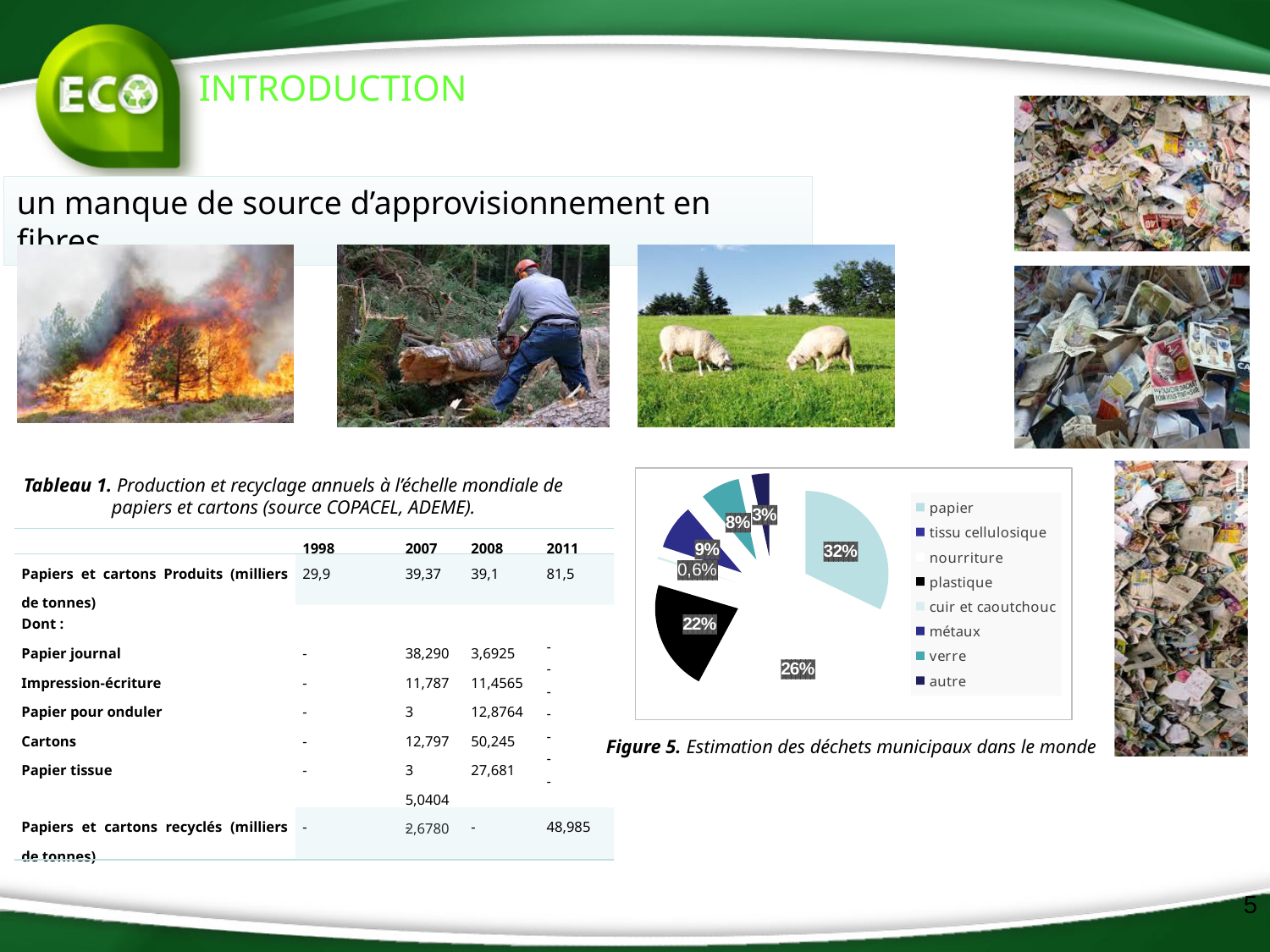
In the pie chart of Figure 5, what share is labelled for nourriture? 26% In the pie chart of Figure 5, what share is labelled for plastique? 22% In the pie chart of Figure 5, what share is labelled for métaux? 9% In the pie chart of Figure 5, what share is labelled for papier? 32% What kind of chart is shown in Figure 5? pie chart What is the caption of Figure 5? Estimation des déchets municipaux dans le monde In the pie chart of Figure 5, what is the difference between the shares of papier and plastique? 10% In the pie chart of Figure 5, what share is labelled for verre? 8% In the pie chart of Figure 5, which is larger: nourriture or plastique? nourriture Which category has the largest slice in the pie chart of Figure 5? papier In the pie chart of Figure 5, what share is labelled for autre? 3% How many entries does the legend of the pie chart in Figure 5 list? 8